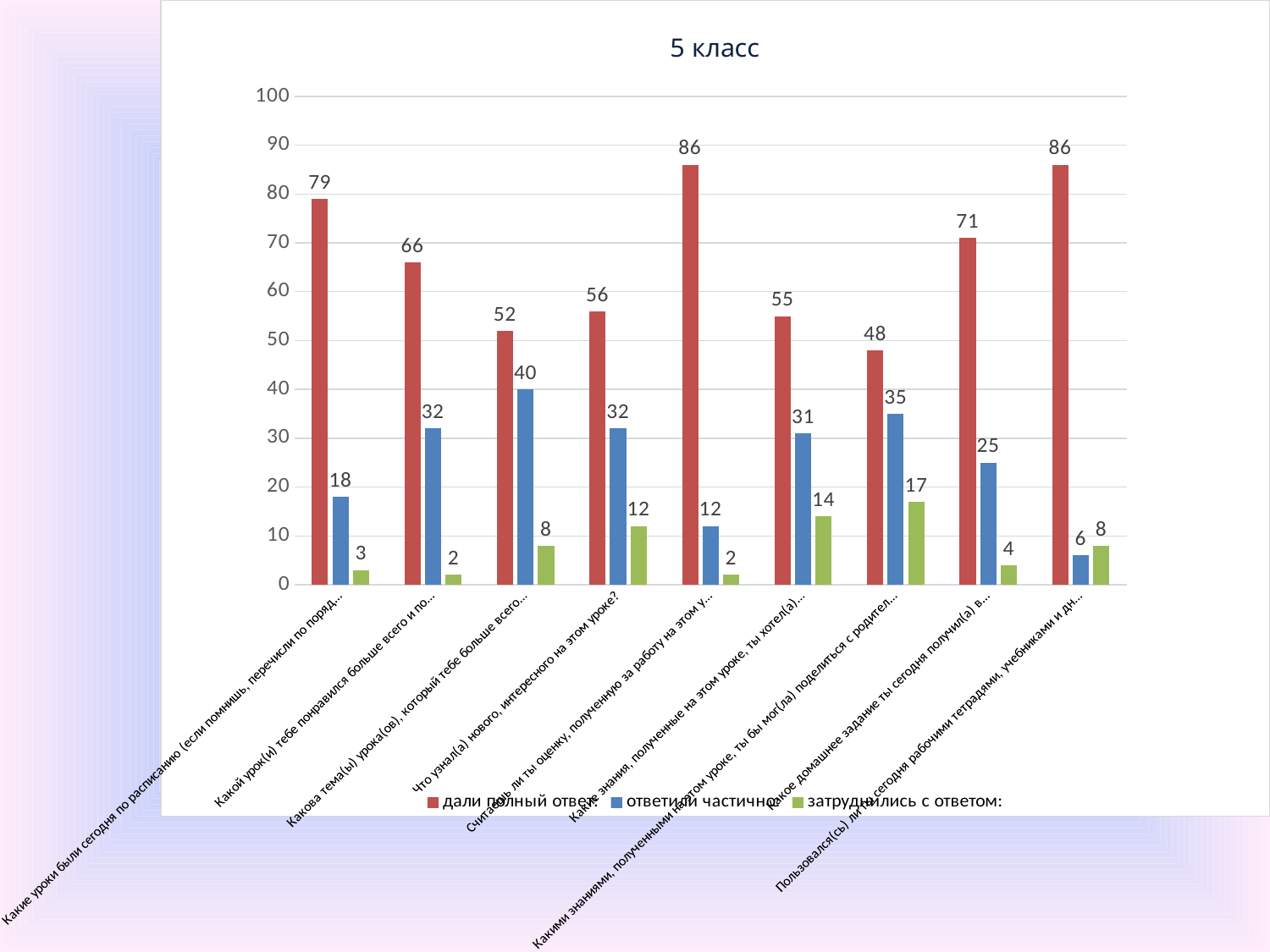
Which category has the highest value for "затруднились с ответом"? Какими знаниями, полученными на этом уроке, ты бы мог(ла) поделиться с родител... What is the difference between "дали полный ответ" and "ответили частично" for the category "Какое домашнее задание ты сегодня получил(а) в..."? 46 What is the title of the chart? 5 класс What is the value of "затруднились с ответом" for the category "Какие знания, полученные на этом уроке, ты хотел(а)..."? 14 For the category "Какой урок(и) тебе понравился больше всего и по...", which is larger: "дали полный ответ" or "ответили частично"? дали полный ответ Which category has the lowest value for "дали полный ответ"? Какими знаниями, полученными на этом уроке, ты бы мог(ла) поделиться с родител... Which category has the highest value for "ответили частично"? Какова тема(ы) урока(ов), который тебе больше всего... What is the value of "ответили частично" for the category "Какова тема(ы) урока(ов), который тебе больше всего..."? 40 How many categories (questions) are plotted along the x axis? 9 What type of chart is shown on the slide? bar chart What is the value of "дали полный ответ" for the category "Что узнал(а) нового, интересного на этом уроке?"? 56 How many series does the legend list? 3